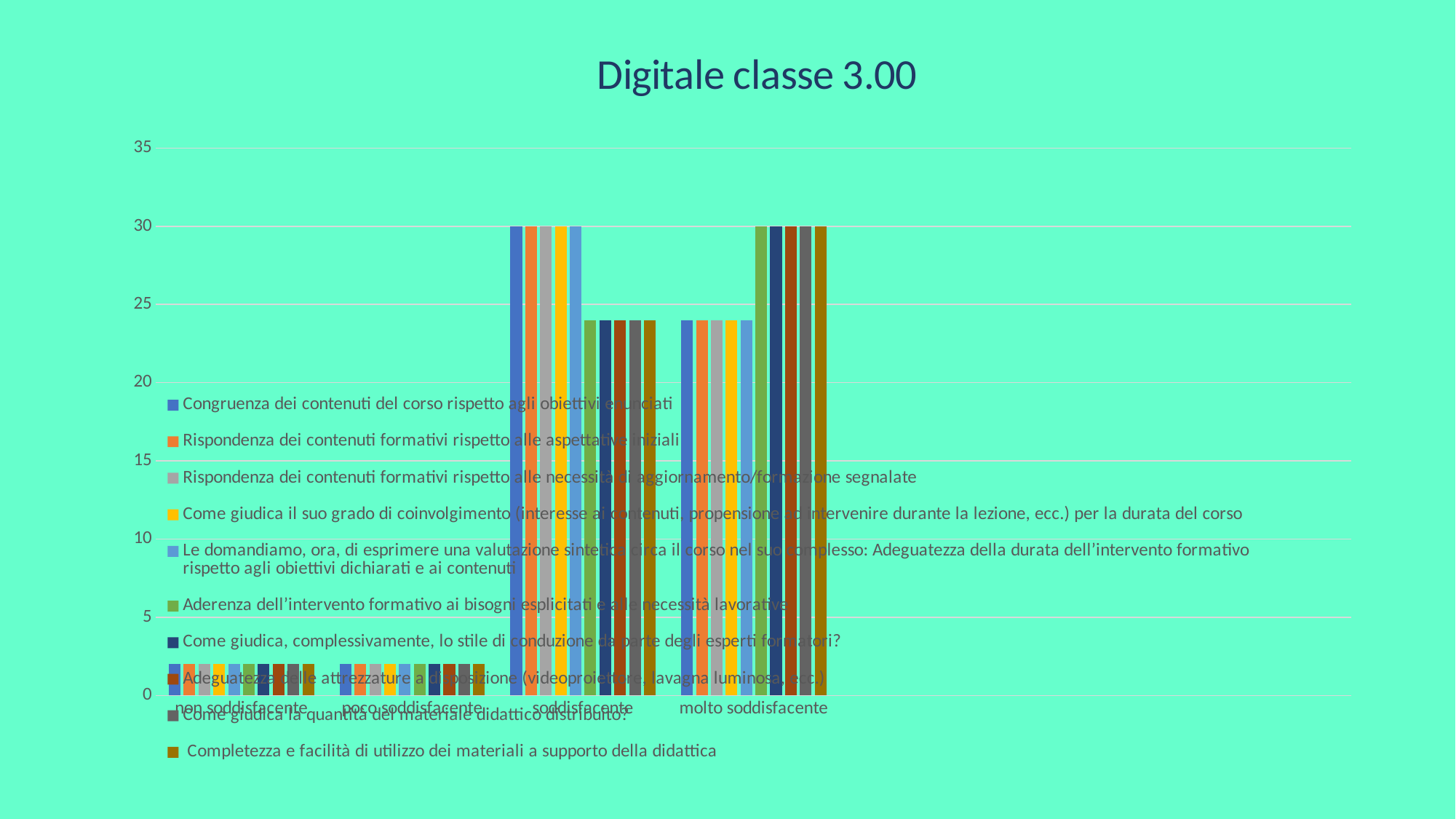
What is the value for 'Congruenza dei contenuti del corso rispetto agli obiettivi enunciati' in the 'soddisfacente' category? 30 How many series does the legend list? 10 What is the value for 'Completezza e facilità di utilizzo dei materiali a supporto della didattica' in the 'molto soddisfacente' category? 30 How many categories are shown on the x axis? 4 Which series is listed first in the legend? Congruenza dei contenuti del corso rispetto agli obiettivi enunciati Is the value for 'Congruenza dei contenuti del corso rispetto agli obiettivi enunciati' in the 'non soddisfacente' category greater or less than 5? less What kind of chart is shown on the slide? bar chart For 'Completezza e facilità di utilizzo dei materiali a supporto della didattica', which category has the highest value? molto soddisfacente What is the title of the chart? Digitale classe 3.00 Is the value for 'Completezza e facilità di utilizzo dei materiali a supporto della didattica' in the 'soddisfacente' category greater or less than 25? less For 'Congruenza dei contenuti del corso rispetto agli obiettivi enunciati', which is larger: the value for 'soddisfacente' or for 'molto soddisfacente'? soddisfacente Is the value for 'Congruenza dei contenuti del corso rispetto agli obiettivi enunciati' in the 'molto soddisfacente' category greater or less than 25? less